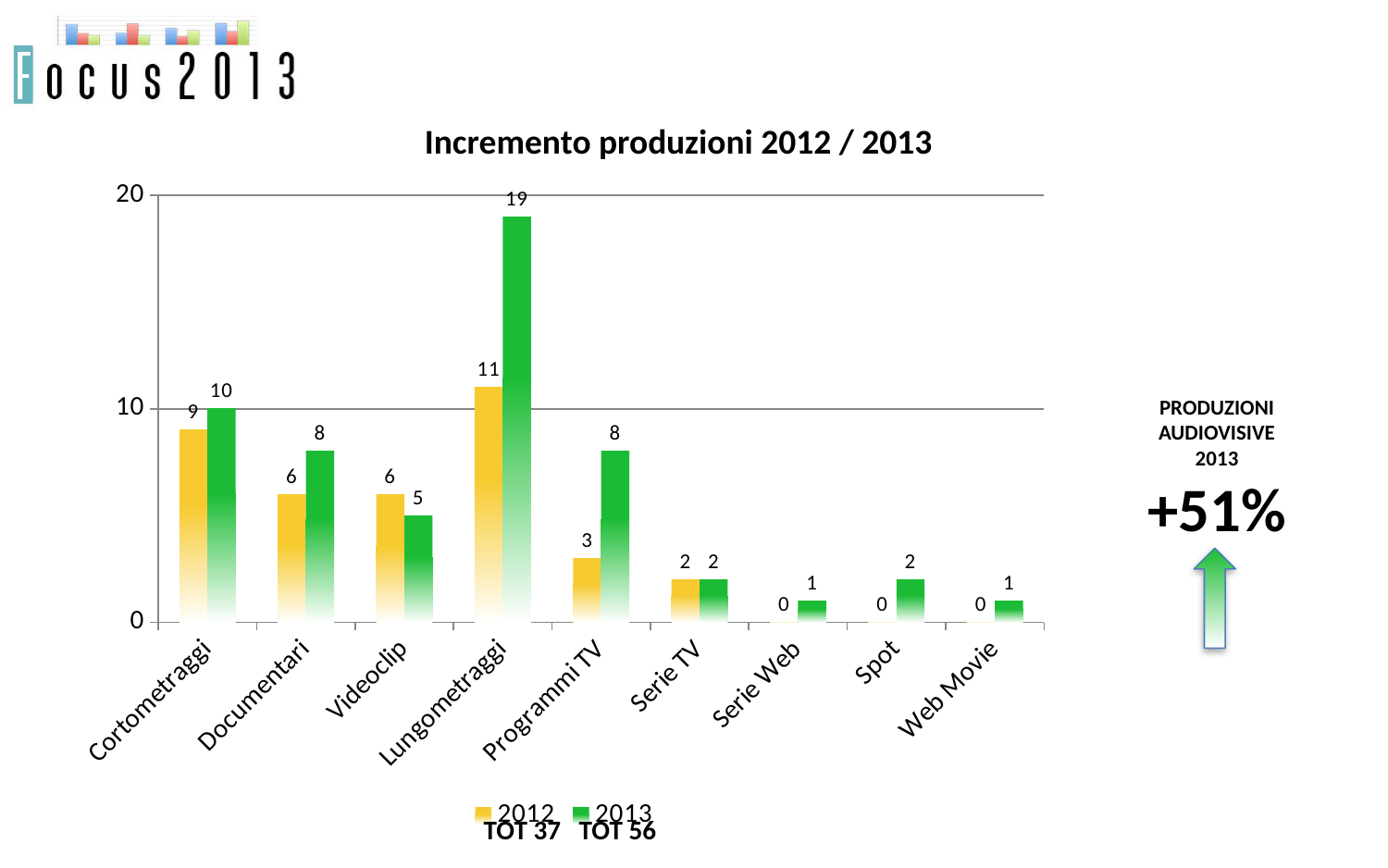
How many series does the legend list? 2 Which is larger for Documentari, the 2012 value or the 2013 value? 2013 What type of chart is shown? Bar chart What is the 2012 value for Programmi TV? 3 Which is larger for Videoclip, the 2012 value or the 2013 value? 2012 What is the difference between the 2013 and 2012 values for Programmi TV? 5 Which category has the highest 2013 value? Lungometraggi What is the difference between the 2013 and 2012 values for Lungometraggi? 8 What is the 2013 value for Lungometraggi? 19 Which category has the highest 2012 value? Lungometraggi What is the 2012 value for Videoclip? 6 How many categories are shown on the x axis? 9